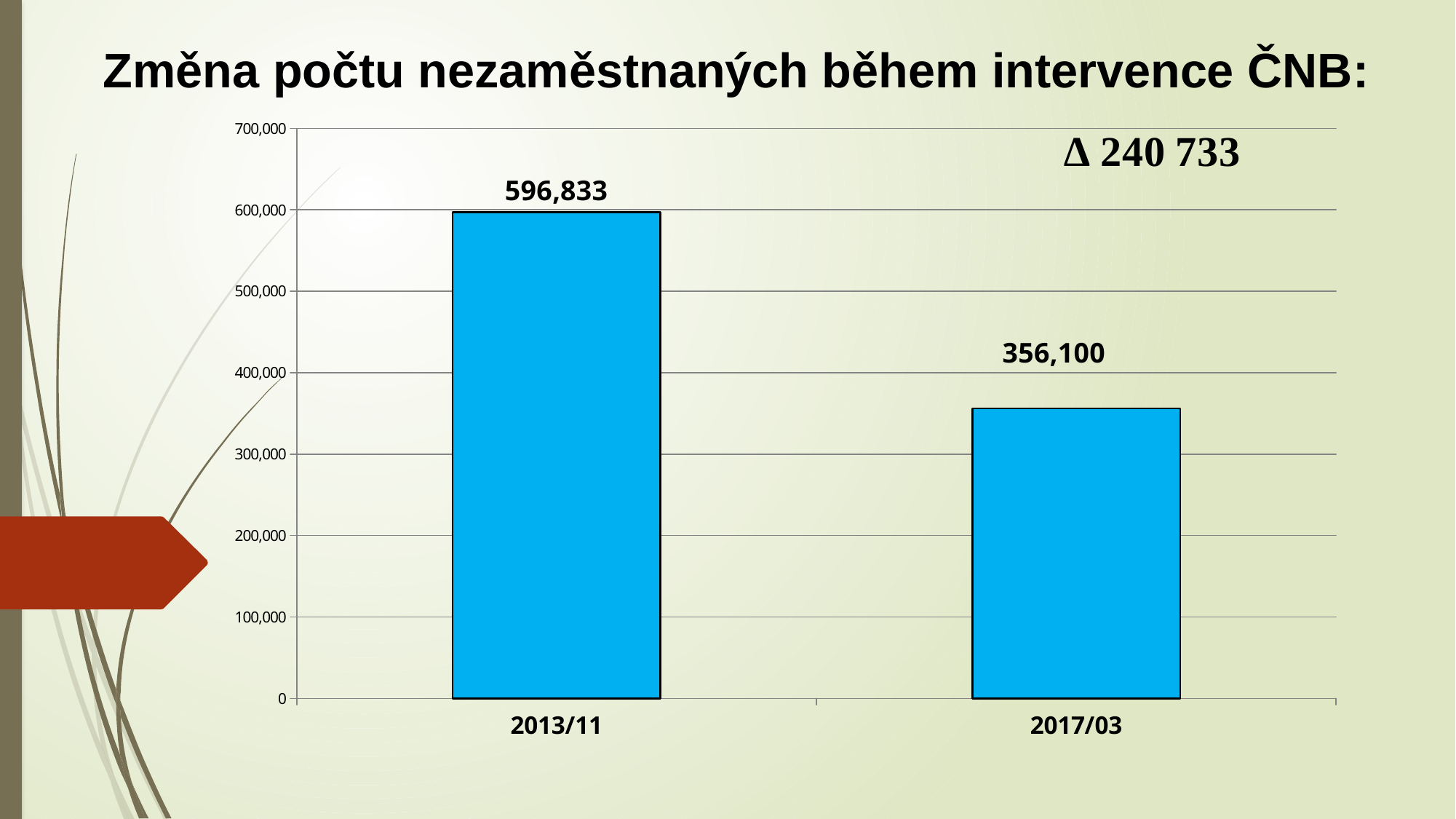
What is the value for 2013/11? 596,833 What is the difference between the values for 2013/11 and 2017/03? 240,733 Do the values rise or fall from 2013/11 to 2017/03? fall What is the value for 2017/03? 356,100 Is the value for 2017/03 greater or less than 400,000? less What kind of chart is shown on the slide? bar chart Which is larger, the value for 2013/11 or the value for 2017/03? 2013/11 How many categories are shown on the x axis? 2 What is the title of the slide? Změna počtu nezaměstnaných během intervence ČNB: Is the value for 2013/11 greater or less than 500,000? greater Which category has the highest value? 2013/11 Which category has the lowest value? 2017/03